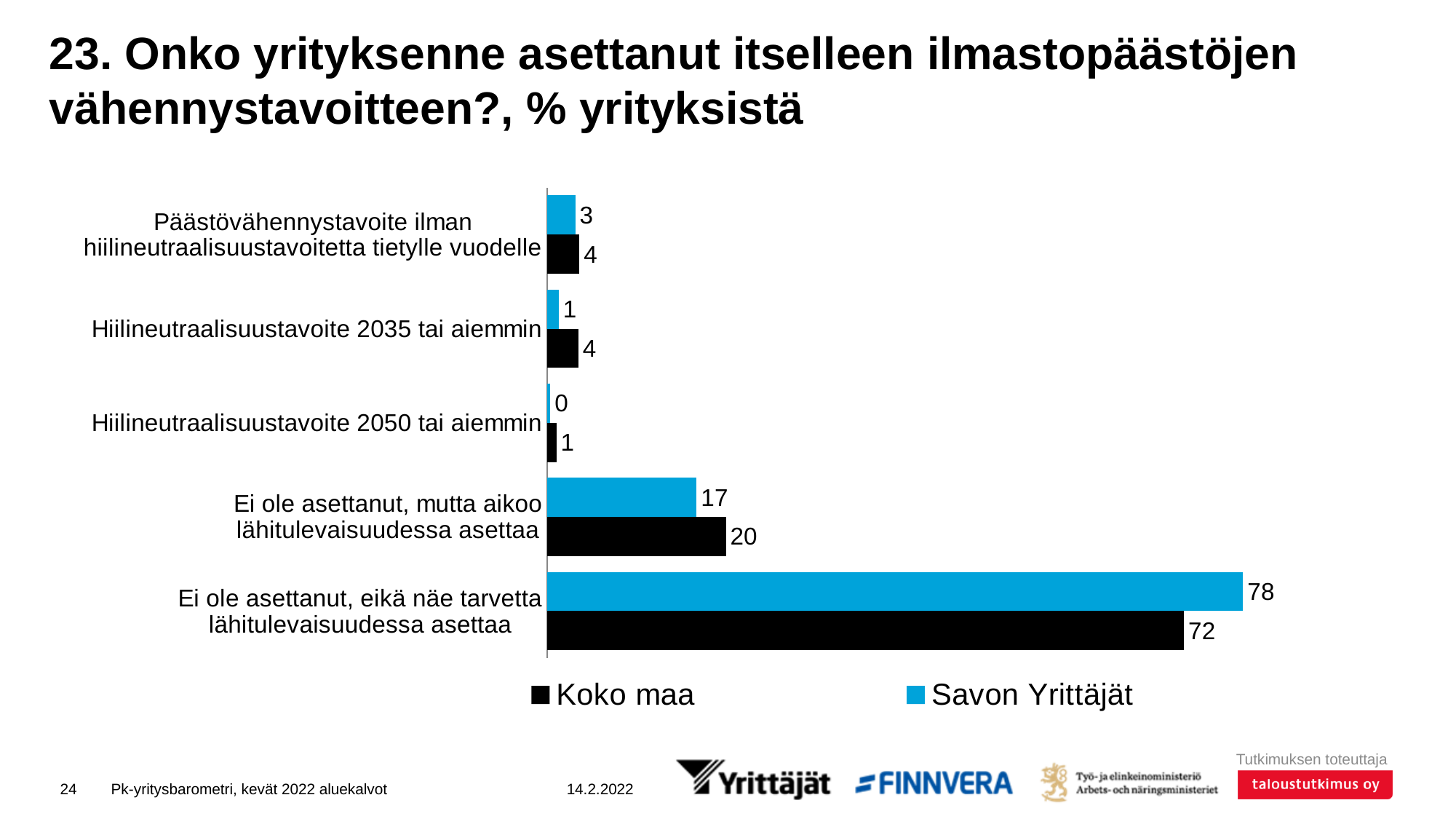
What is the value for Savon Yrittäjät in the category "Ei ole asettanut, eikä näe tarvetta lähitulevaisuudessa asettaa"? 78 What is the difference between Savon Yrittäjät and Koko maa in the category "Ei ole asettanut, eikä näe tarvetta lähitulevaisuudessa asettaa"? 6 In the category "Ei ole asettanut, mutta aikoo lähitulevaisuudessa asettaa", which series has the larger value, Koko maa or Savon Yrittäjät? Koko maa What is the value for Koko maa in the category "Ei ole asettanut, mutta aikoo lähitulevaisuudessa asettaa"? 20 What is the value for Koko maa in the category "Päästövähennystavoite ilman hiilineutraalisuustavoitetta tietylle vuodelle"? 4 Which category has the highest value for Koko maa? Ei ole asettanut, eikä näe tarvetta lähitulevaisuudessa asettaa How many categories are shown on the chart? 5 Which colour represents the Savon Yrittäjät series? Blue What kind of chart is shown on the slide? Bar chart What is the value for Savon Yrittäjät in the category "Hiilineutraalisuustavoite 2035 tai aiemmin"? 1 How many series does the legend list? 2 Which category has the lowest value for Savon Yrittäjät? Hiilineutraalisuustavoite 2050 tai aiemmin